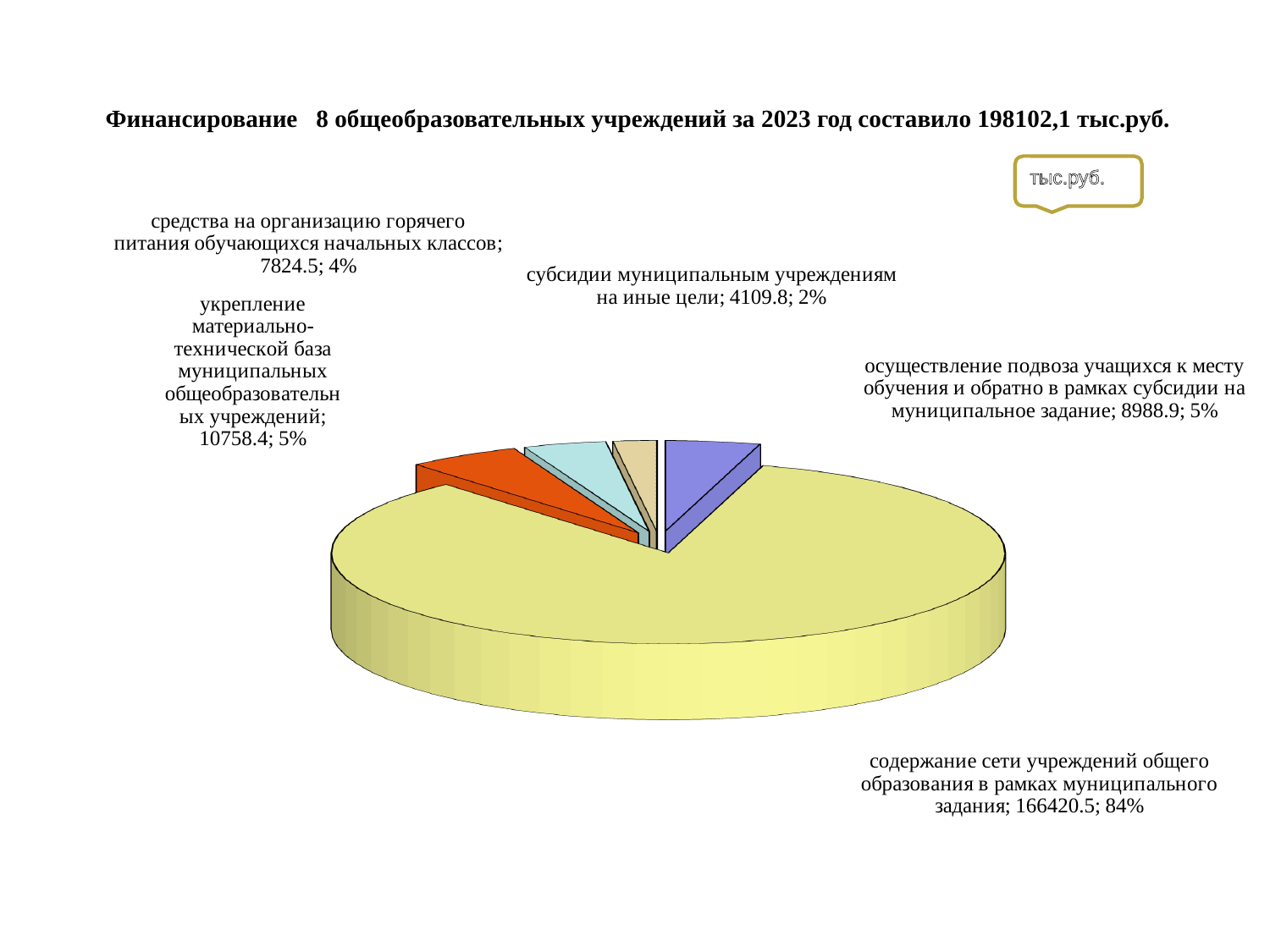
What is the value for 'средства на организацию горячего питания обучающихся начальных классов'? 7824.5 What is the difference between the values for 'укрепление материально-технической базы муниципальных общеобразовательных учреждений' and 'средства на организацию горячего питания обучающихся начальных классов'? 2933.9 According to the slide title, what was the total financing of the 8 general education institutions in 2023? 198102,1 тыс.руб. Which is larger: the value for 'укрепление материально-технической базы муниципальных общеобразовательных учреждений' or for 'осуществление подвоза учащихся к месту обучения и обратно в рамках субсидии на муниципальное задание'? укрепление материально-технической базы муниципальных общеобразовательных учреждений What share of the pie does 'содержание сети учреждений общего образования в рамках муниципального задания' represent? 84% Which category has the largest slice of the pie? содержание сети учреждений общего образования в рамках муниципального задания What is the value for 'субсидии муниципальным учреждениям на иные цели'? 4109.8 What share of the pie does 'средства на организацию горячего питания обучающихся начальных классов' represent? 4% How many slices does the pie chart have? 5 What is the value for 'содержание сети учреждений общего образования в рамках муниципального задания'? 166420.5 Which category has the smallest slice of the pie? субсидии муниципальным учреждениям на иные цели What type of chart is shown on the slide? pie chart